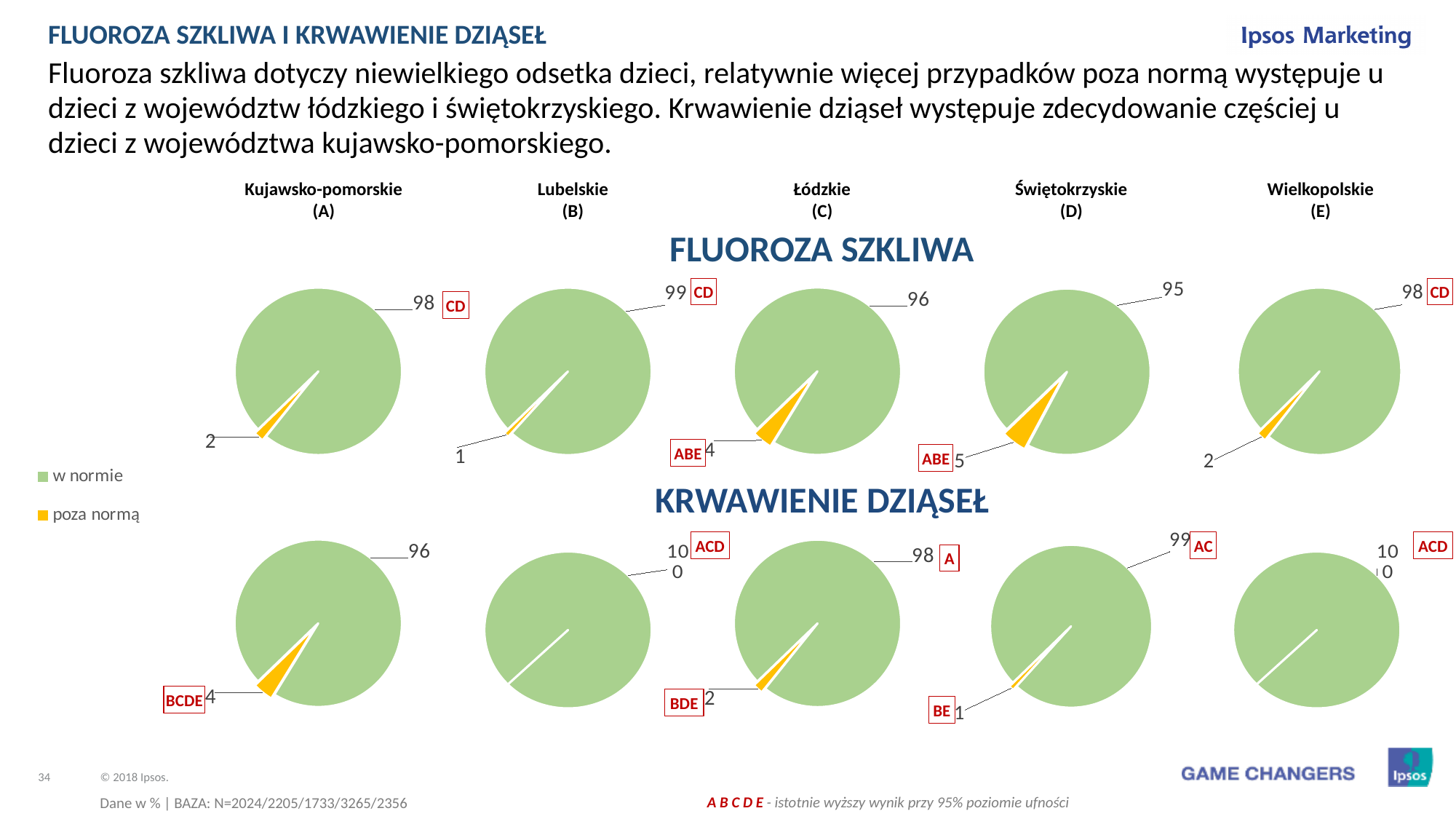
In the KRWAWIENIE DZIĄSEŁ row, what is the 'w normie' value for Świętokrzyskie (D)? 99 In the KRWAWIENIE DZIĄSEŁ row, which is larger: the 'poza normą' value for Łódzkie (C) or for Świętokrzyskie (D)? Łódzkie (C) In the FLUOROZA SZKLIWA row, what is the 'poza normą' value for Łódzkie (C)? 4 How many pie charts are shown in the FLUOROZA SZKLIWA row? 5 In the FLUOROZA SZKLIWA row, what is the 'w normie' value for Kujawsko-pomorskie (A)? 98 In the FLUOROZA SZKLIWA row, what is the difference between the 'w normie' values for Lubelskie (B) and Świętokrzyskie (D)? 4 In the KRWAWIENIE DZIĄSEŁ row, which voivodeship has the highest 'poza normą' value? Kujawsko-pomorskie (A) In the KRWAWIENIE DZIĄSEŁ row, what is the 'poza normą' value for Kujawsko-pomorskie (A)? 4 In the FLUOROZA SZKLIWA row, which voivodeship has the lowest 'poza normą' value? Lubelskie (B) How many series does the legend list? 2 In the FLUOROZA SZKLIWA row, what is the 'poza normą' value for Świętokrzyskie (D)? 5 In the FLUOROZA SZKLIWA row, which voivodeship has the highest 'poza normą' value? Świętokrzyskie (D)